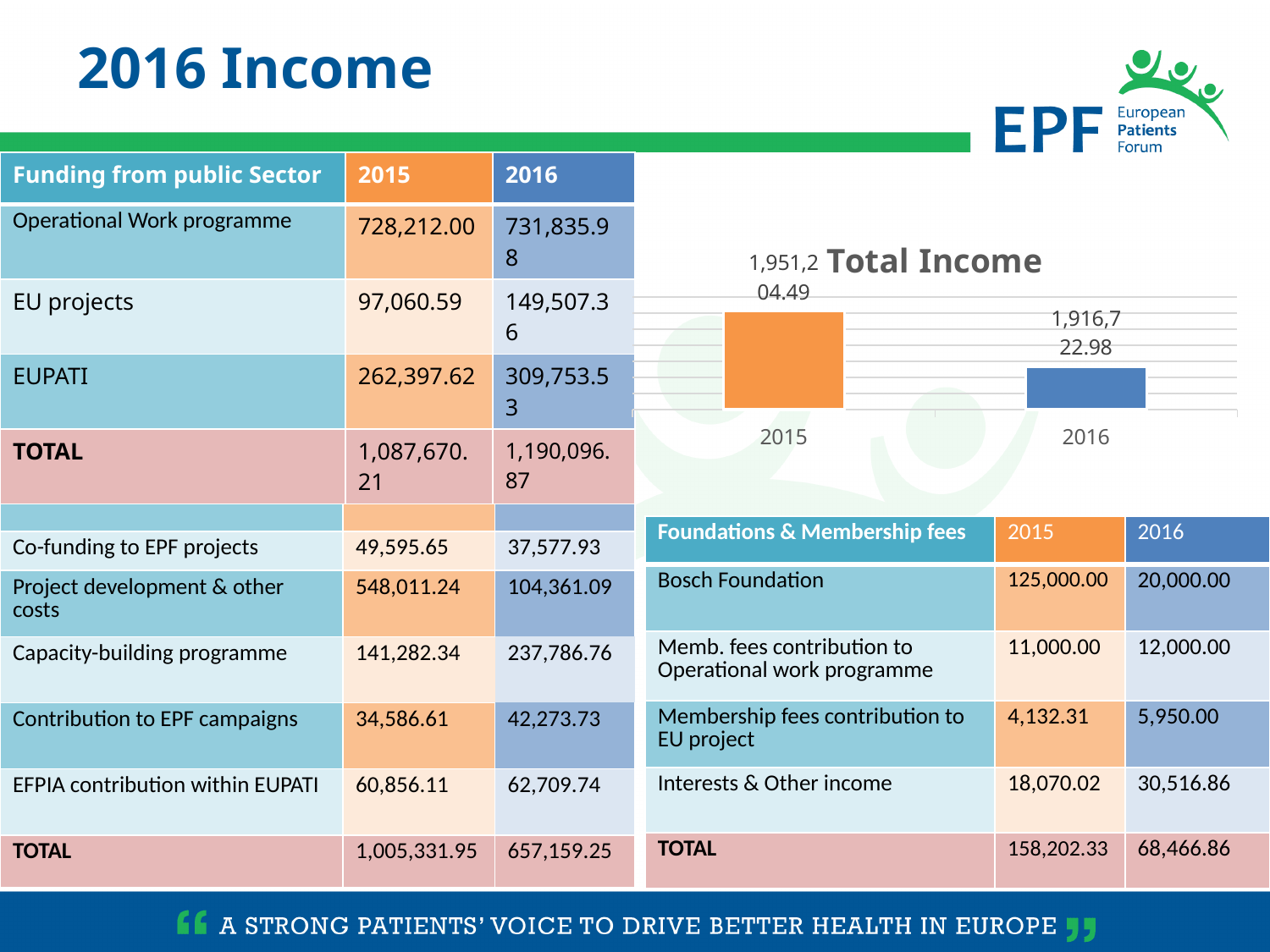
What is the title of the chart on the slide? Total Income In the Total Income chart, which year has the lower total income? 2016 In the Total Income chart, is the value for 2016 larger or smaller than the value for 2015? smaller In the Total Income chart, does total income rise or fall from 2015 to 2016? fall How many bars are plotted in the Total Income chart? 2 In the Total Income chart, what colour is the 2016 bar? blue In the Total Income chart, what is the value for 2015? 1,951,204.49 What type of chart is the Total Income chart? bar chart In the Total Income chart, what is the difference between the 2015 and 2016 values? 34,481.51 In the Total Income chart, which year has the higher total income? 2015 In the Total Income chart, what is the value for 2016? 1,916,722.98